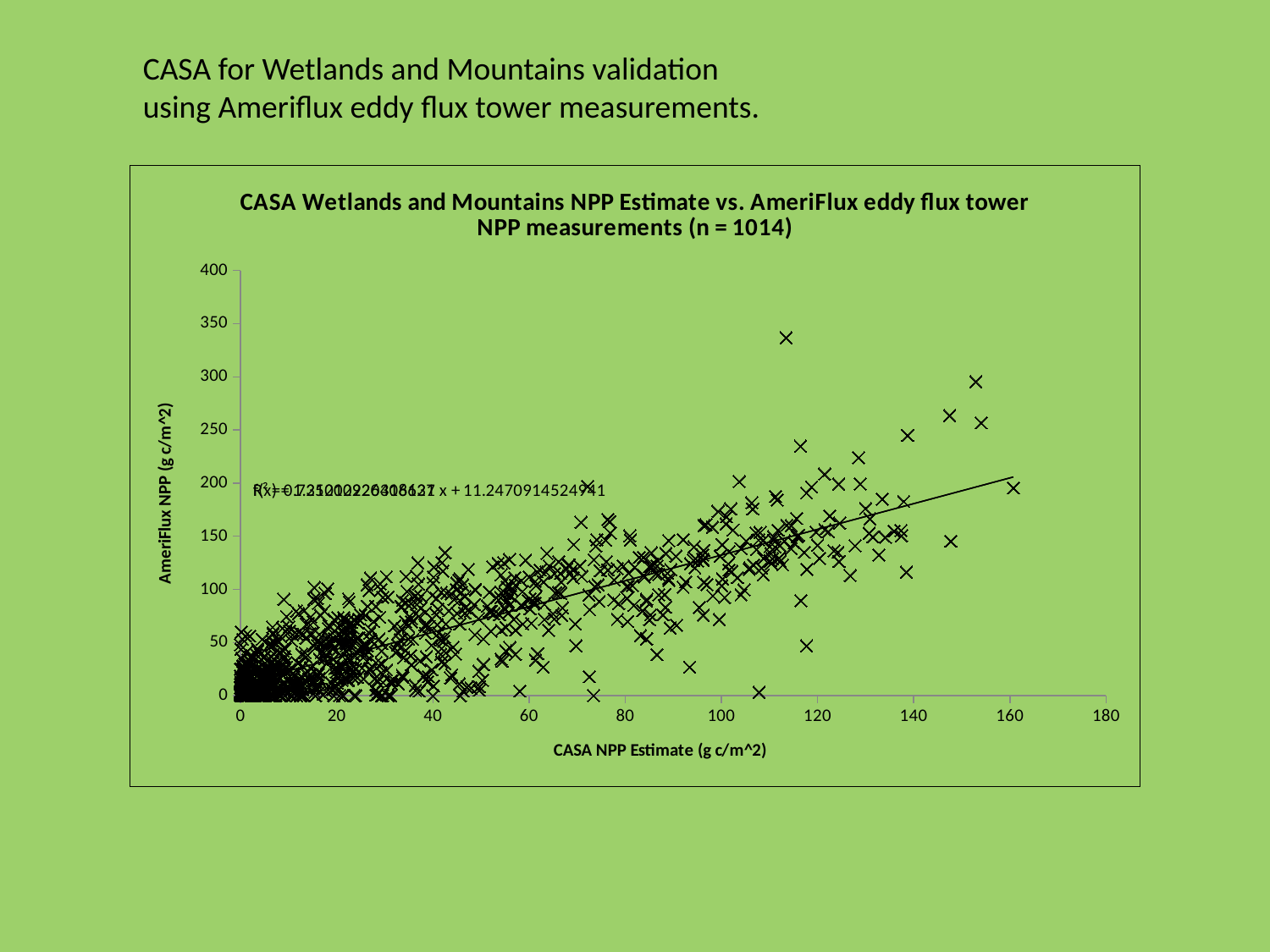
Is the AmeriFlux NPP value of the highest plotted point greater or less than 300? greater Does the fitted trend line slope upward or downward from left to right? upward How many data points does the chart title say are plotted? 1014 What is the highest tick value shown on the x axis? 180 What is the highest tick value shown on the y axis? 400 What kind of chart is shown on the slide? scatter plot Is the CASA NPP Estimate of the highest plotted point greater or less than 100? greater What is the label of the x axis? CASA NPP Estimate (g c/m^2) Is the CASA NPP Estimate of the rightmost plotted point greater or less than 140? greater What is the title of the chart? CASA Wetlands and Mountains NPP Estimate vs. AmeriFlux eddy flux tower NPP measurements (n = 1014) Do the AmeriFlux NPP values generally rise or fall as the CASA NPP Estimate increases along the x axis? rise